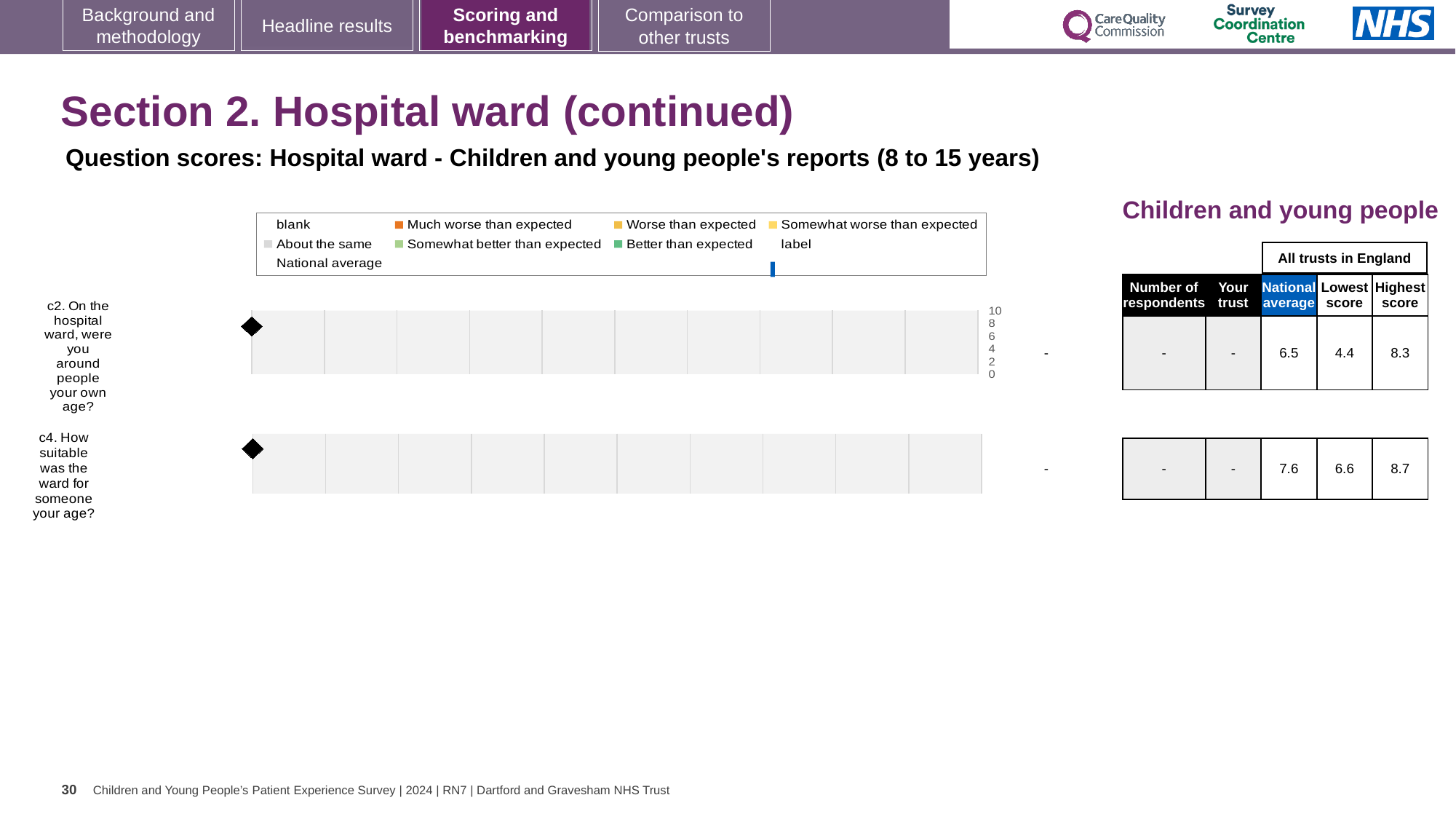
How many questions (categories) are plotted on the chart? 2 What is the highest value shown on the chart's score axis? 10 What is the highest score across all trusts in England for question c4? 8.7 What kind of chart is used to display the question scores for c2 and c4? bar chart What is the difference between the national average scores for c4 and c2? 1.1 What is the difference between the highest and lowest scores across all trusts for question c2? 3.9 What is the lowest value shown on the chart's score axis? 0 What is the national average score for question c2 (On the hospital ward, were you around people your own age?)? 6.5 What value is shown for 'Your trust' for question c2? - Which question has the higher national average score, c2 or c4? c4 What is the national average score for question c4 (How suitable was the ward for someone your age?)? 7.6 What is the lowest score across all trusts in England for question c2? 4.4